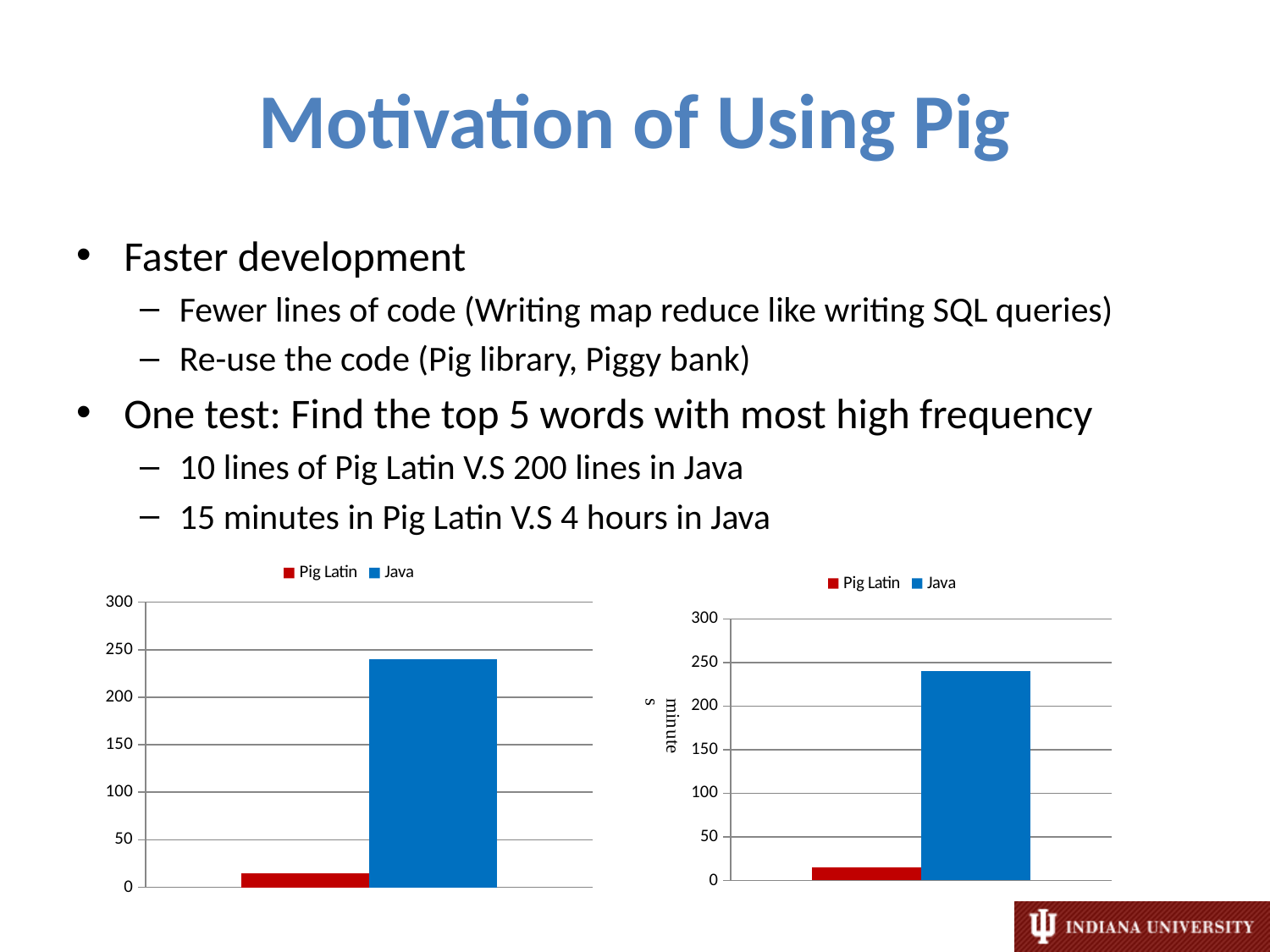
What kind of chart is the left chart on the slide? bar chart What is the label on the vertical axis of the right chart? minutes In the left chart, what colour is the Java series? blue In the right chart, is the value for Pig Latin greater or less than 100? less In the left chart, which series has the taller bar, Pig Latin or Java? Java In the right chart, which series has the shorter bar, Pig Latin or Java? Pig Latin How many series does the legend of the left chart list? 2 In the left chart, is the value for Java greater or less than 200? greater In the right chart, is the value for Java greater or less than 250? less How many series does the legend of the right chart list? 2 What kind of chart is the right chart on the slide? bar chart